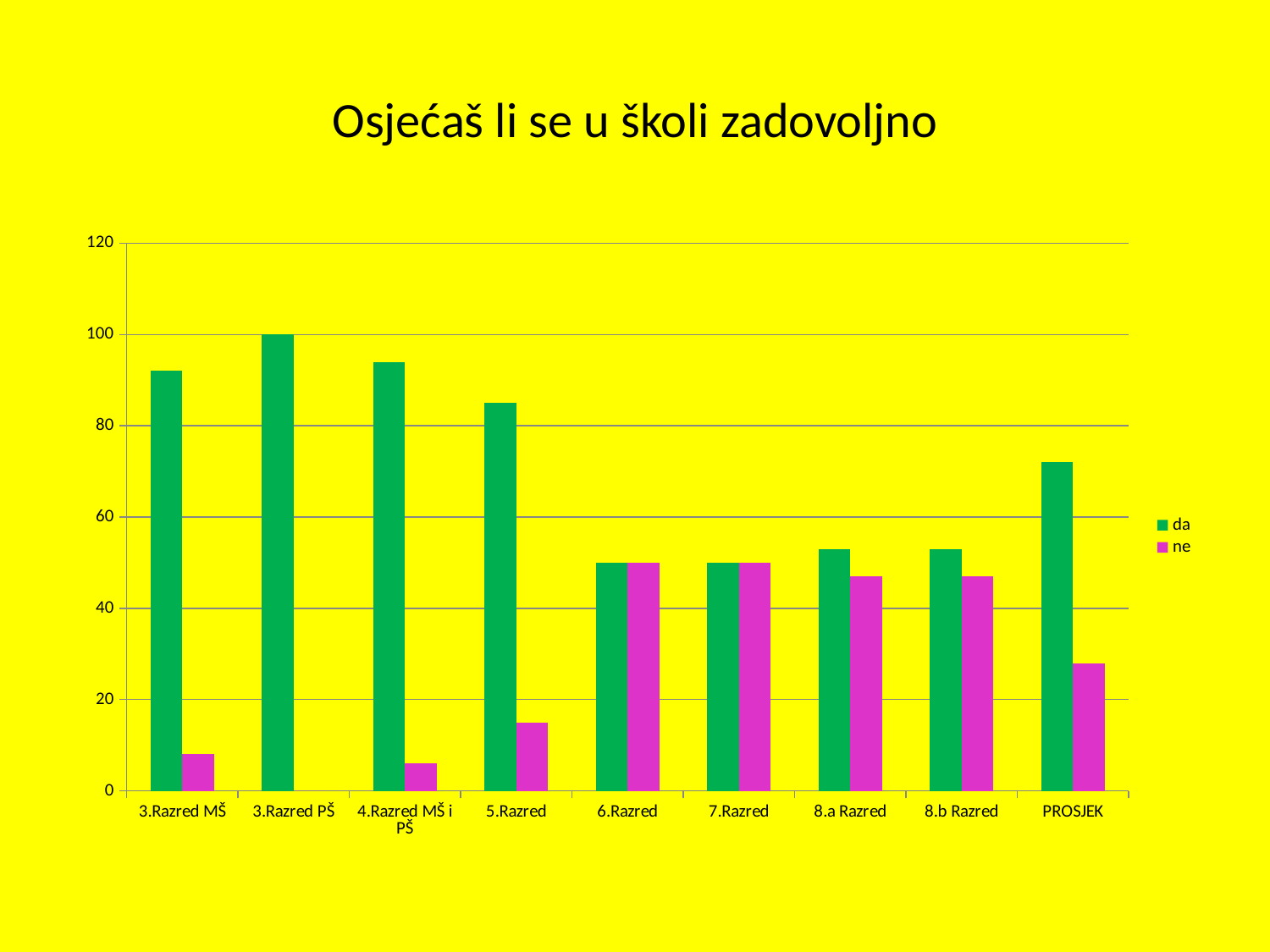
Which category has the highest value for the 'da' series? 3.Razred PŠ Is the 'ne' value for PROSJEK greater or less than 40? less What is the title of the chart? Osjećaš li se u školi zadovoljno How many categories are shown on the x axis? 9 Is the 'da' value for 3.Razred MŠ greater or less than 80? greater What is the value of the 'da' series for 3.Razred PŠ? 100 Which is larger, the 'da' value for 5.Razred or the 'da' value for PROSJEK? 5.Razred Is the 'da' value for PROSJEK greater or less than 60? greater What kind of chart is shown on the slide? bar chart How many series does the legend list? 2 For 3.Razred MŠ, which is larger, the 'da' value or the 'ne' value? da